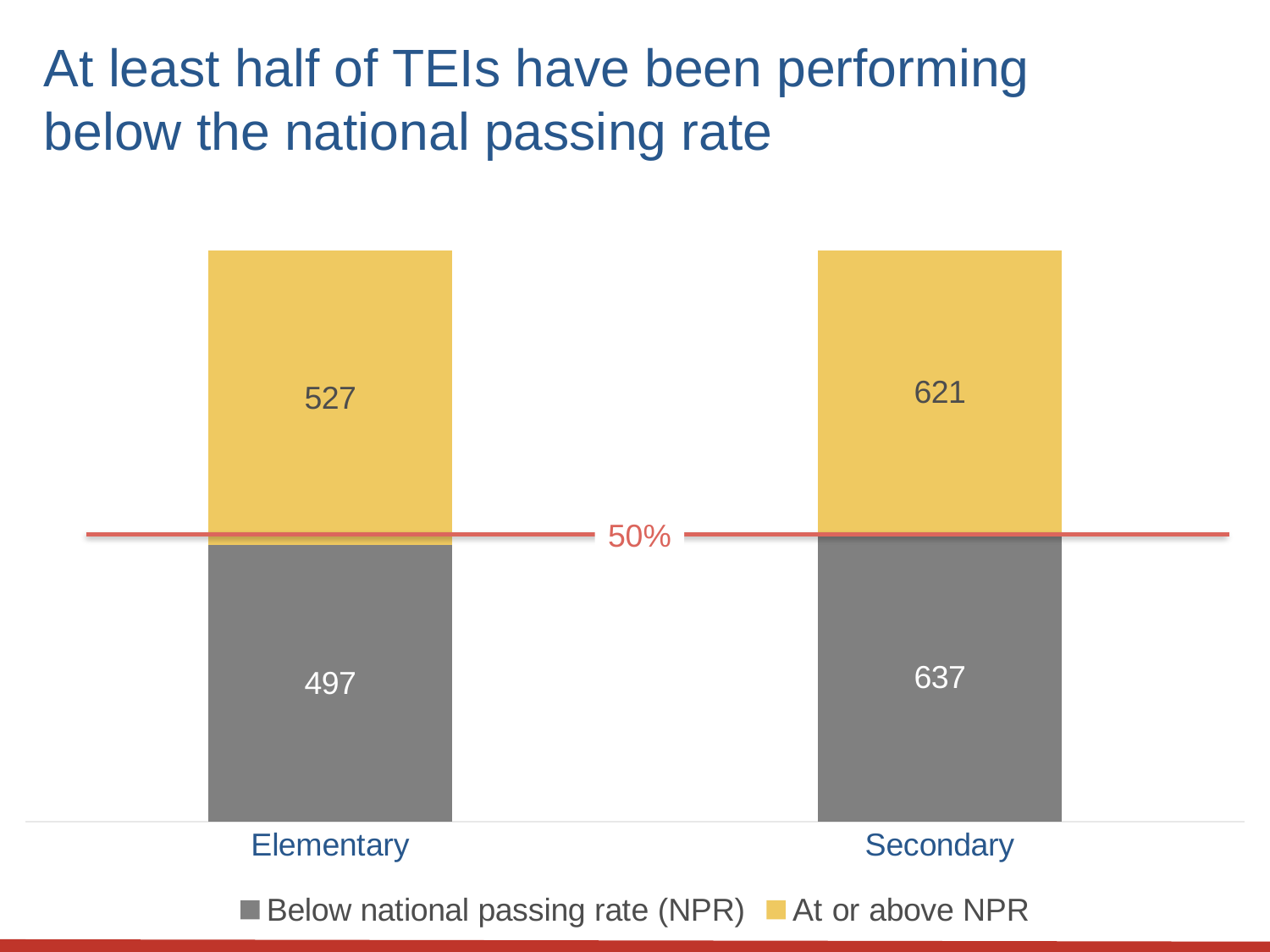
Which category has the lowest value for At or above NPR? Elementary Which category has the highest value for Below national passing rate (NPR)? Secondary How many categories are shown on the x axis? 2 What kind of chart is shown on the slide? Stacked bar chart What is the value for Below national passing rate (NPR) for Elementary? 497 What is the difference between the Below national passing rate (NPR) values for Secondary and Elementary? 140 What is the value for At or above NPR for Secondary? 621 What is the value for At or above NPR for Elementary? 527 How many series does the legend list? 2 For Secondary, which is larger: Below national passing rate (NPR) or At or above NPR? Below national passing rate (NPR) What is the total of the two segments in the Elementary bar? 1024 What is the value for Below national passing rate (NPR) for Secondary? 637